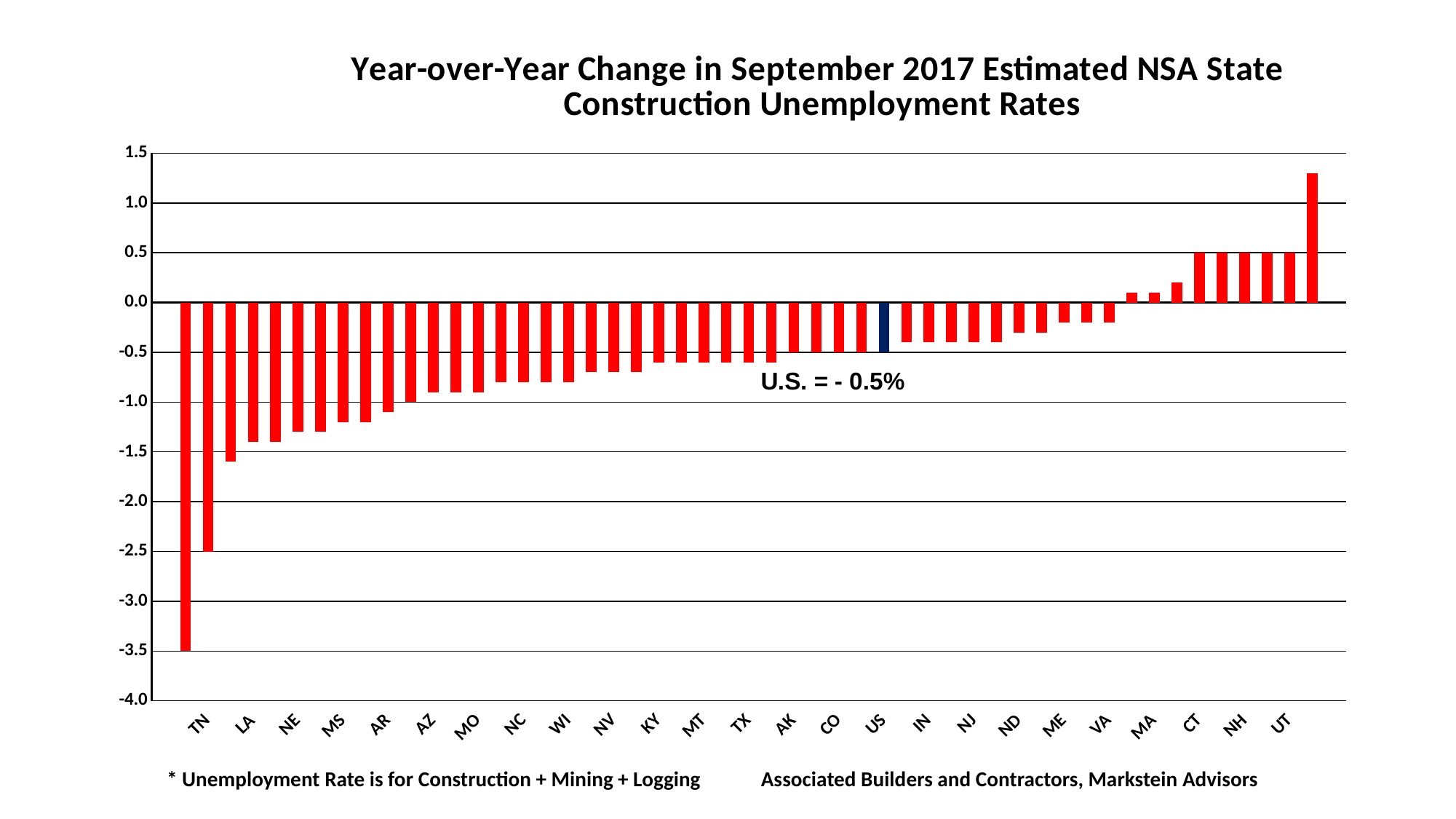
Is the value for CT greater or less than 0.0? greater What kind of chart is shown on the slide? bar chart Which has the larger value, LA or CT? CT Is the value for ME greater or less than -0.5? greater What is the value shown for the U.S. in the chart? -0.5% Is the value for NV greater or less than -1.0? greater Which has the larger value, MS or NJ? NJ What is the title of the chart? Year-over-Year Change in September 2017 Estimated NSA State Construction Unemployment Rates How many bars in the chart are above 1.0? 1 Do the values generally rise or fall moving from left to right along the x axis? rise